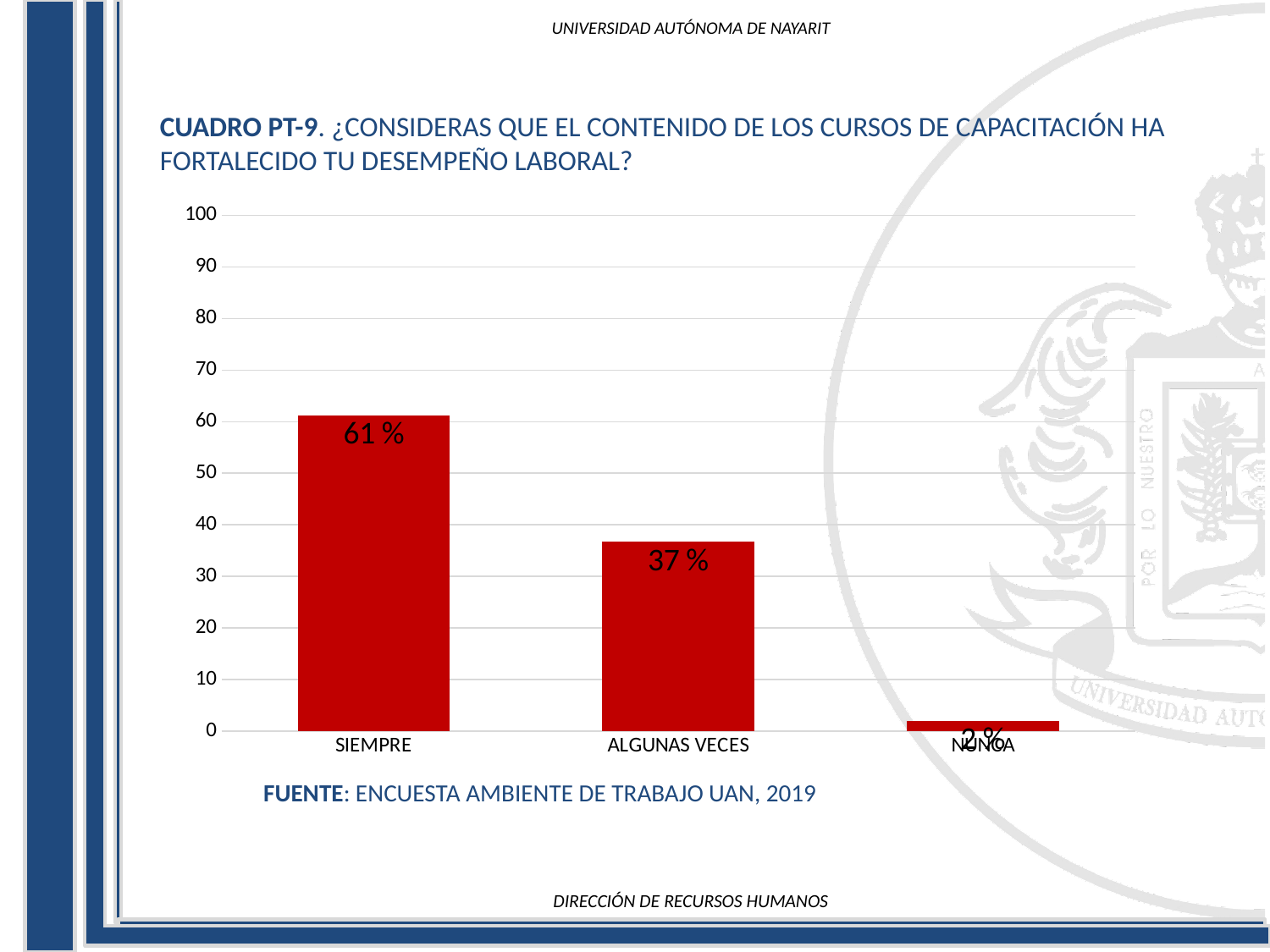
What kind of chart is shown on the slide? bar chart What is the value for NUNCA? 2 % Which category has the highest value? SIEMPRE What is the value for ALGUNAS VECES? 37 % How many categories are shown on the x axis? 3 What source is cited below the chart? ENCUESTA AMBIENTE DE TRABAJO UAN, 2019 What is the difference between the values for ALGUNAS VECES and NUNCA? 35 % Which is larger, the value for SIEMPRE or the value for ALGUNAS VECES? SIEMPRE What is the difference between the values for SIEMPRE and ALGUNAS VECES? 24 % Is the value for ALGUNAS VECES greater or less than 40? less What is the value for SIEMPRE? 61 % Which category has the lowest value? NUNCA